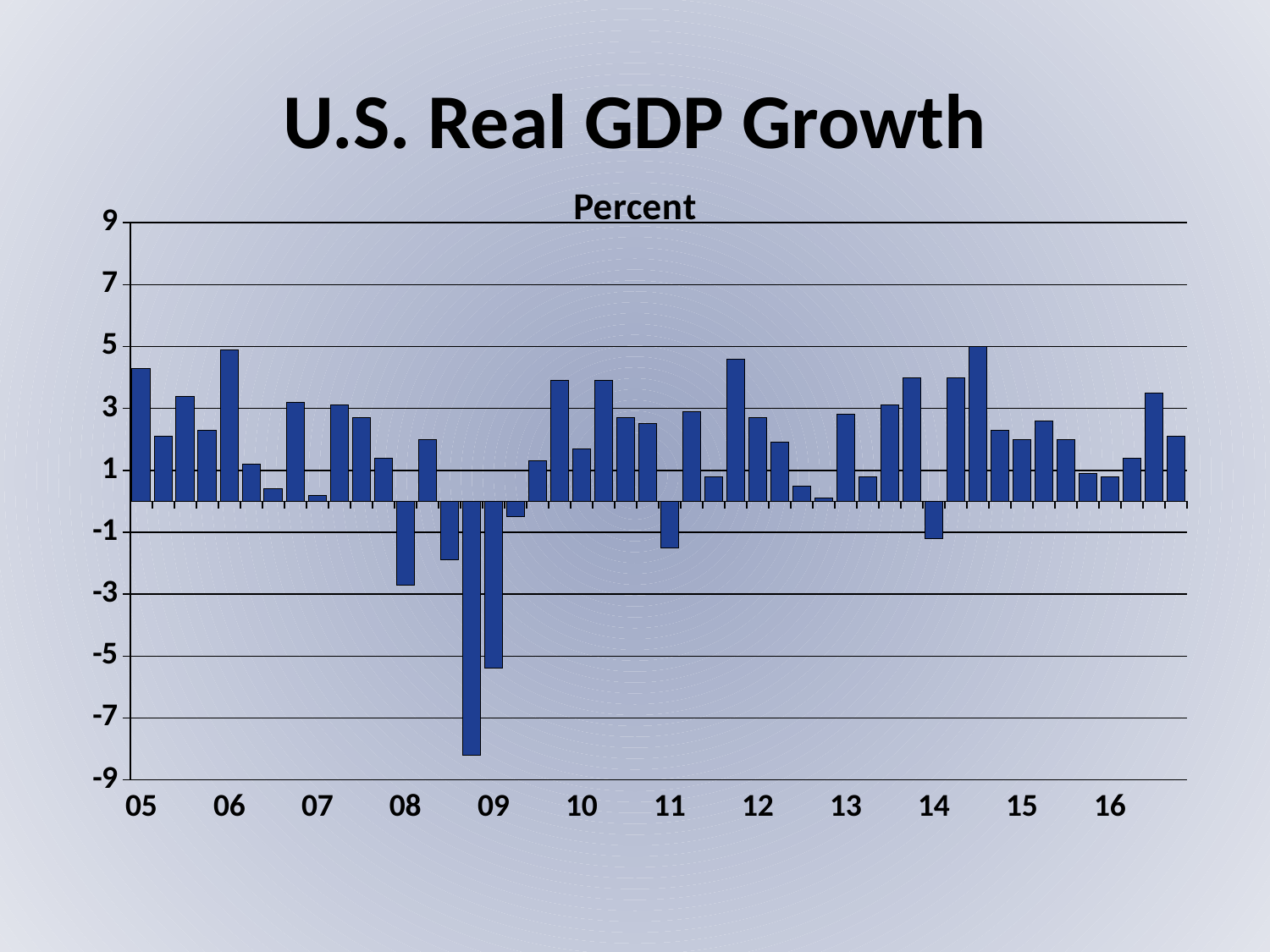
Is the first bar for 11 greater or less than -1? less How many year labels are shown along the x axis? 12 Is the first bar for 10 greater or less than 3? less What is the title of the chart? U.S. Real GDP Growth Is the lowest bar on the chart greater or less than -7? less What unit label is shown above the y axis? Percent How many bars extend below zero? 7 What kind of chart is shown on the slide? bar chart What is the highest value shown on the y axis? 9 What is the lowest value shown on the y axis? -9